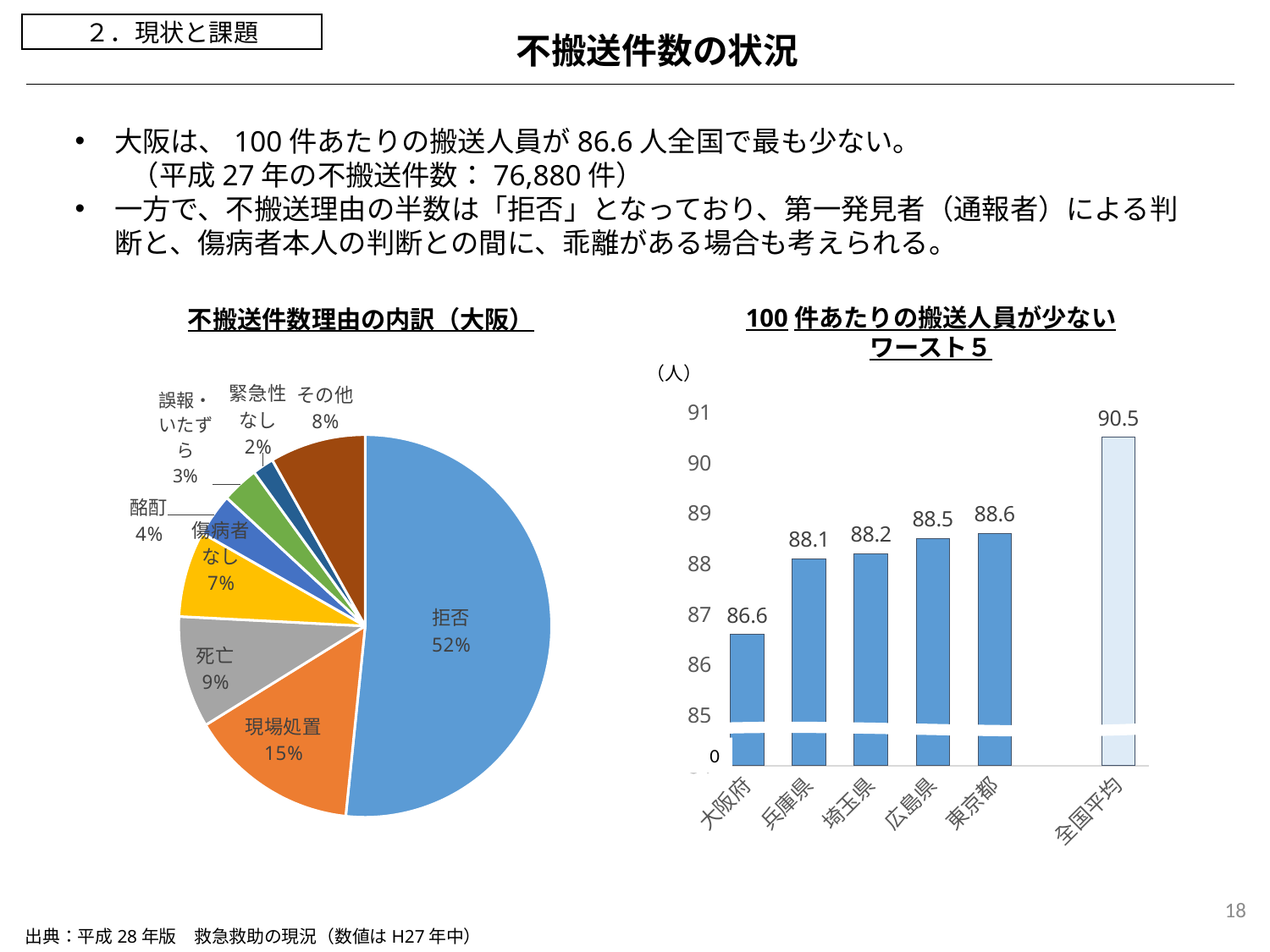
In the bar chart 100件あたりの搬送人員が少ないワースト５, what is the value for 全国平均? 90.5 In the bar chart 100件あたりの搬送人員が少ないワースト５, how many bars are plotted? 6 In the pie chart 不搬送件数理由の内訳（大阪）, what is the difference in percentage points between 死亡 and 傷病者なし? 2 In the bar chart 100件あたりの搬送人員が少ないワースト５, what is the difference between 全国平均 and 大阪府? 3.9 In the bar chart 100件あたりの搬送人員が少ないワースト５, which prefecture has the lowest value? 大阪府 In the pie chart 不搬送件数理由の内訳（大阪）, which is larger, 酩酊 or 誤報・いたずら? 酩酊 In the bar chart 100件あたりの搬送人員が少ないワースト５, what is the value for 大阪府? 86.6 In the pie chart 不搬送件数理由の内訳（大阪）, what share does 拒否 account for? 52% In the pie chart 不搬送件数理由の内訳（大阪）, which category has the smallest share? 緊急性なし In the pie chart 不搬送件数理由の内訳（大阪）, what percentage is 現場処置? 15% What type of chart is 100件あたりの搬送人員が少ないワースト５? Bar chart In the pie chart 不搬送件数理由の内訳（大阪）, how many slices are there? 8